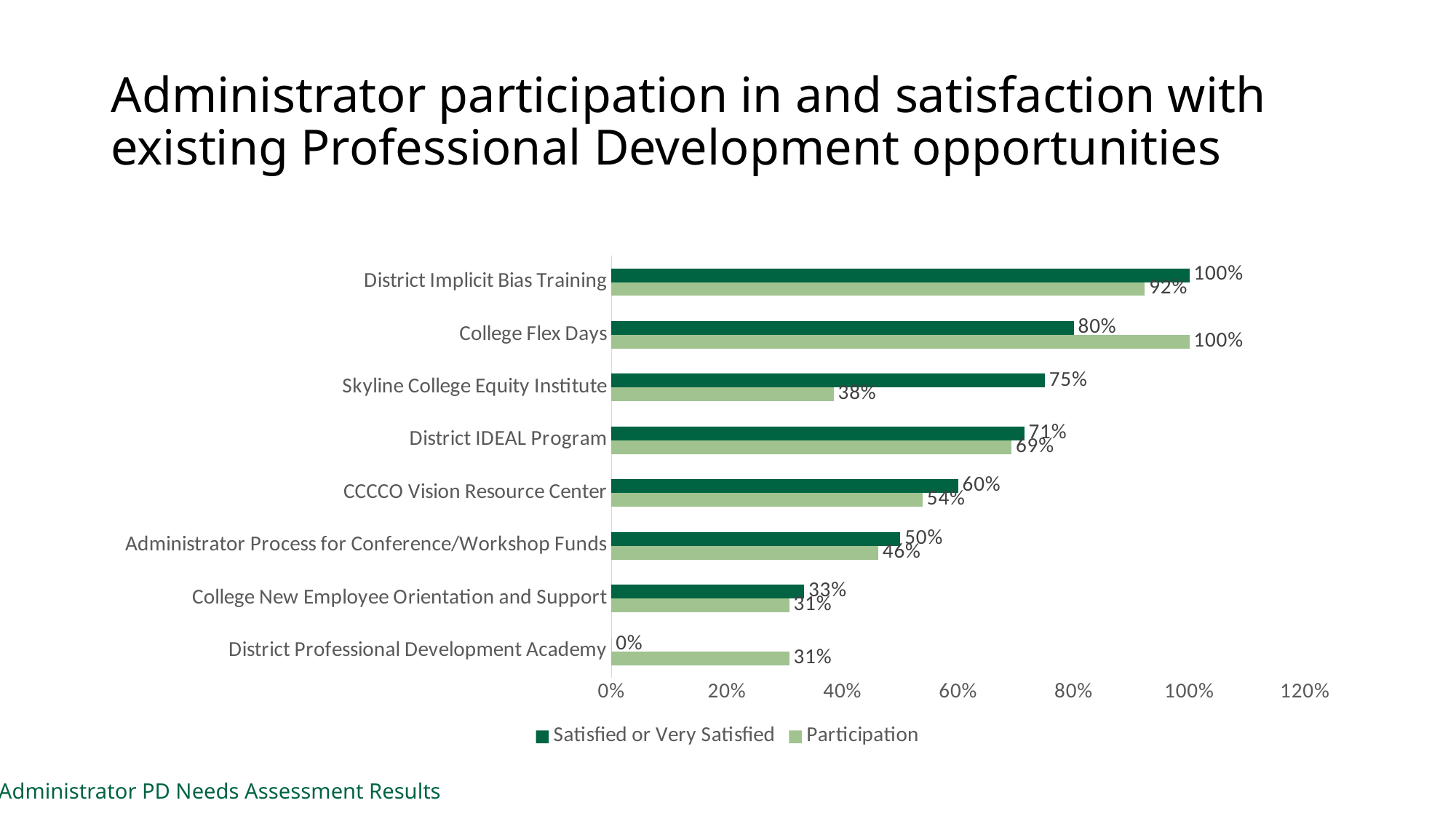
Which category has the lowest Satisfied or Very Satisfied value? District Professional Development Academy How many categories are shown on the chart? 8 Which is larger for College Flex Days: the Satisfied or Very Satisfied value or the Participation value? Participation What is the difference between the Satisfied or Very Satisfied and Participation values for Skyline College Equity Institute? 37% What kind of chart is shown on the slide? Bar chart What is the Satisfied or Very Satisfied value for CCCCO Vision Resource Center? 60% What is the Participation value for Skyline College Equity Institute? 38% What is the Participation value for District Implicit Bias Training? 92% Which category has the highest Participation value? College Flex Days What is the Satisfied or Very Satisfied value for College Flex Days? 80% What is the Satisfied or Very Satisfied value for District Professional Development Academy? 0% How many series does the legend list? 2